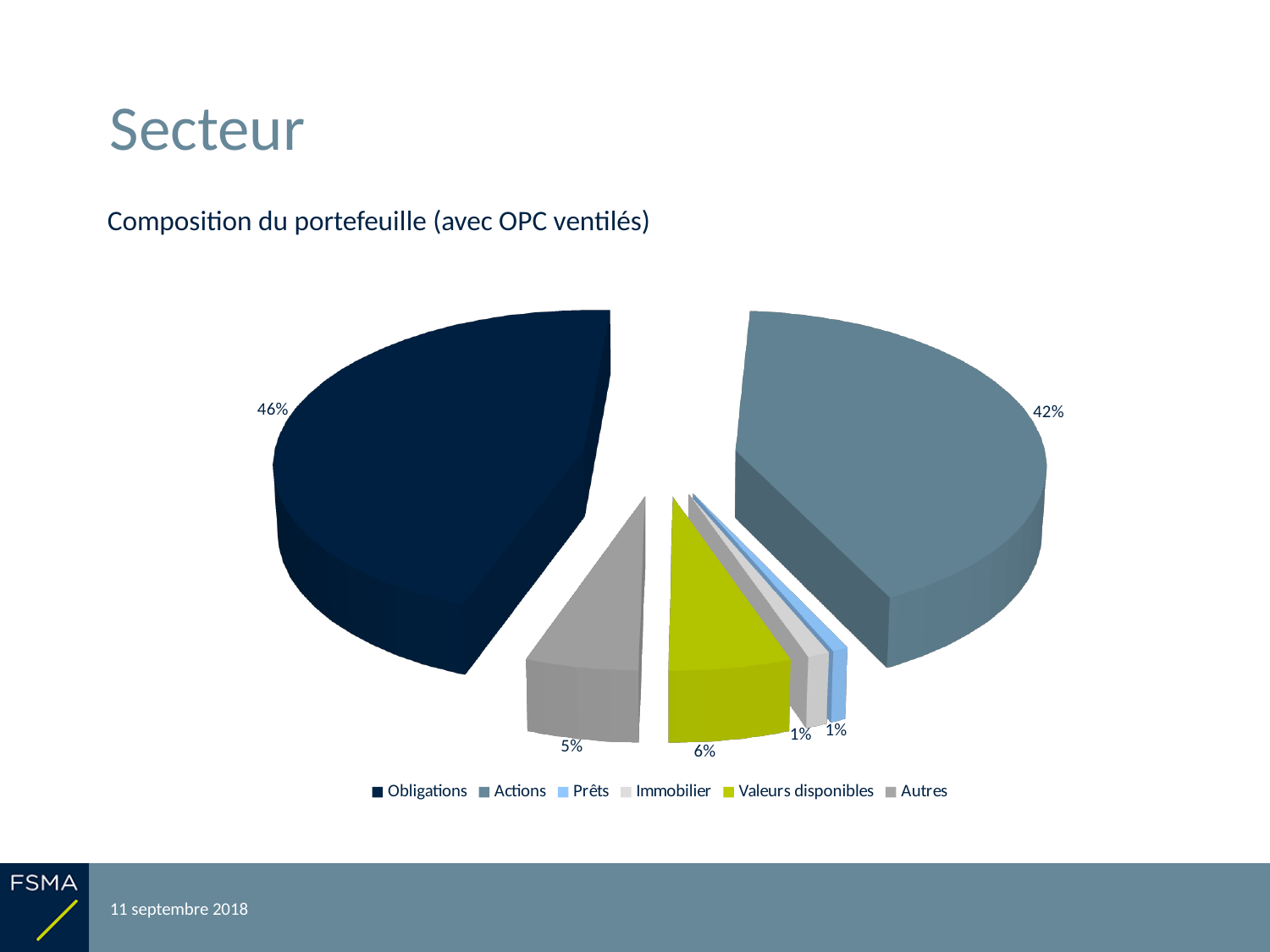
Which colour represents Prêts in the legend? light blue What percentage is shown for Valeurs disponibles? 6% What share of the portfolio is Actions? 42% What percentage is shown for Autres? 5% Which is larger, Valeurs disponibles or Autres? Valeurs disponibles What share of the portfolio is Obligations? 46% Which category has the largest slice of the pie? Obligations What is the title of the chart? Composition du portefeuille (avec OPC ventilés) What kind of chart is shown on the slide? pie chart What is the difference in percentage points between Obligations and Actions? 4 How many categories does the legend list? 6 What percentage is shown for Immobilier? 1%